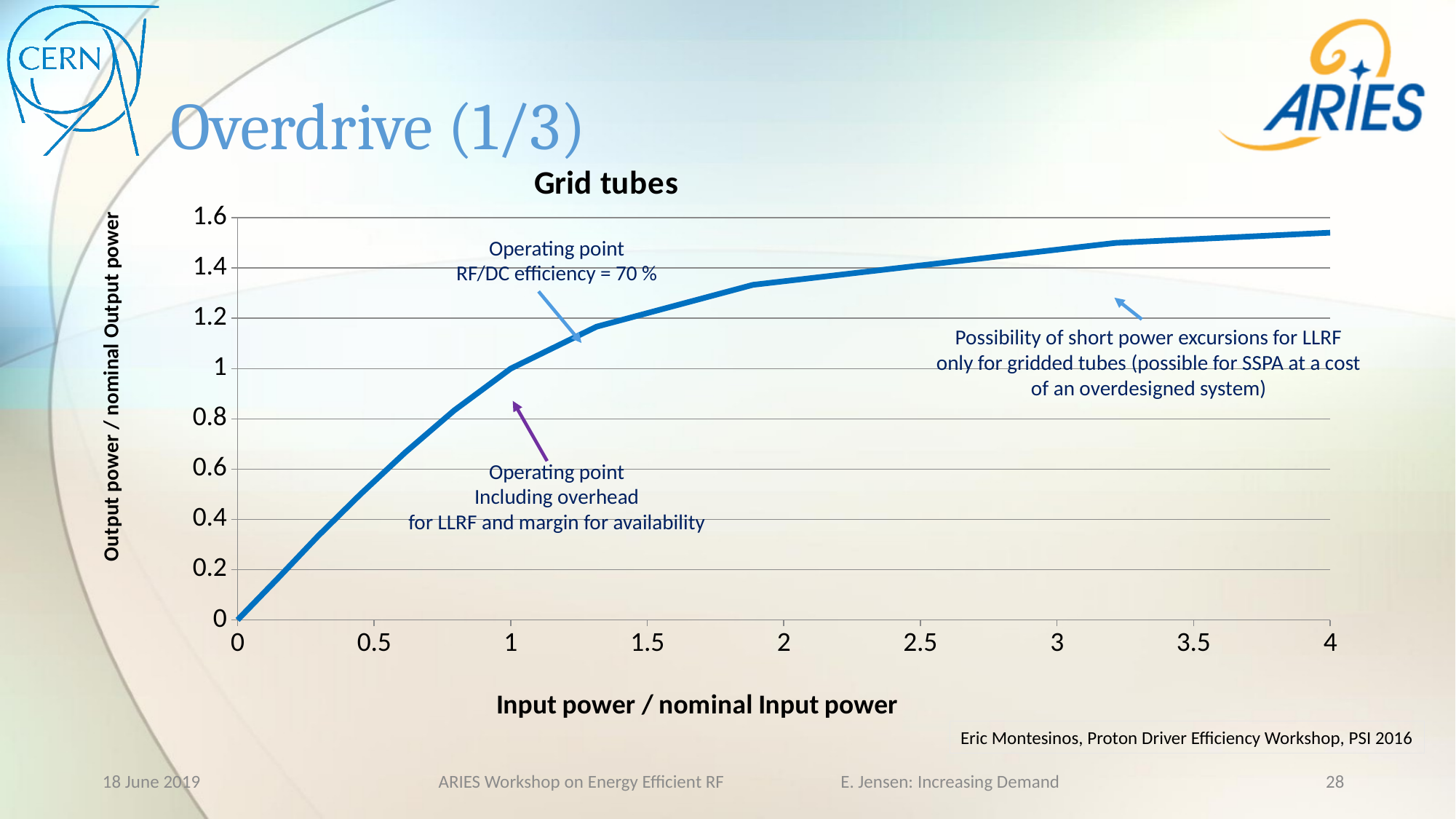
What is the label of the x axis of the chart? Input power / nominal Input power What is the value of Output power / nominal Output power when Input power / nominal Input power is 1? 1 Which is larger: the output power ratio at an input power ratio of 1 or at an input power ratio of 2? at 2 Do the values on the chart rise or fall as the input power ratio increases along the x axis? rise Is the value of Output power / nominal Output power at an input power ratio of 3 greater or less than 1.2? greater What is the value of Output power / nominal Output power when Input power / nominal Input power is 0? 0 What kind of chart is shown on the slide? line chart At which value of Input power / nominal Input power shown on the x axis is the output power ratio highest? 4 What is the title of the chart? Grid tubes Is the value of Output power / nominal Output power at an input power ratio of 2 greater or less than 1.2? greater Is the value of Output power / nominal Output power at an input power ratio of 4 greater or less than 1.4? greater